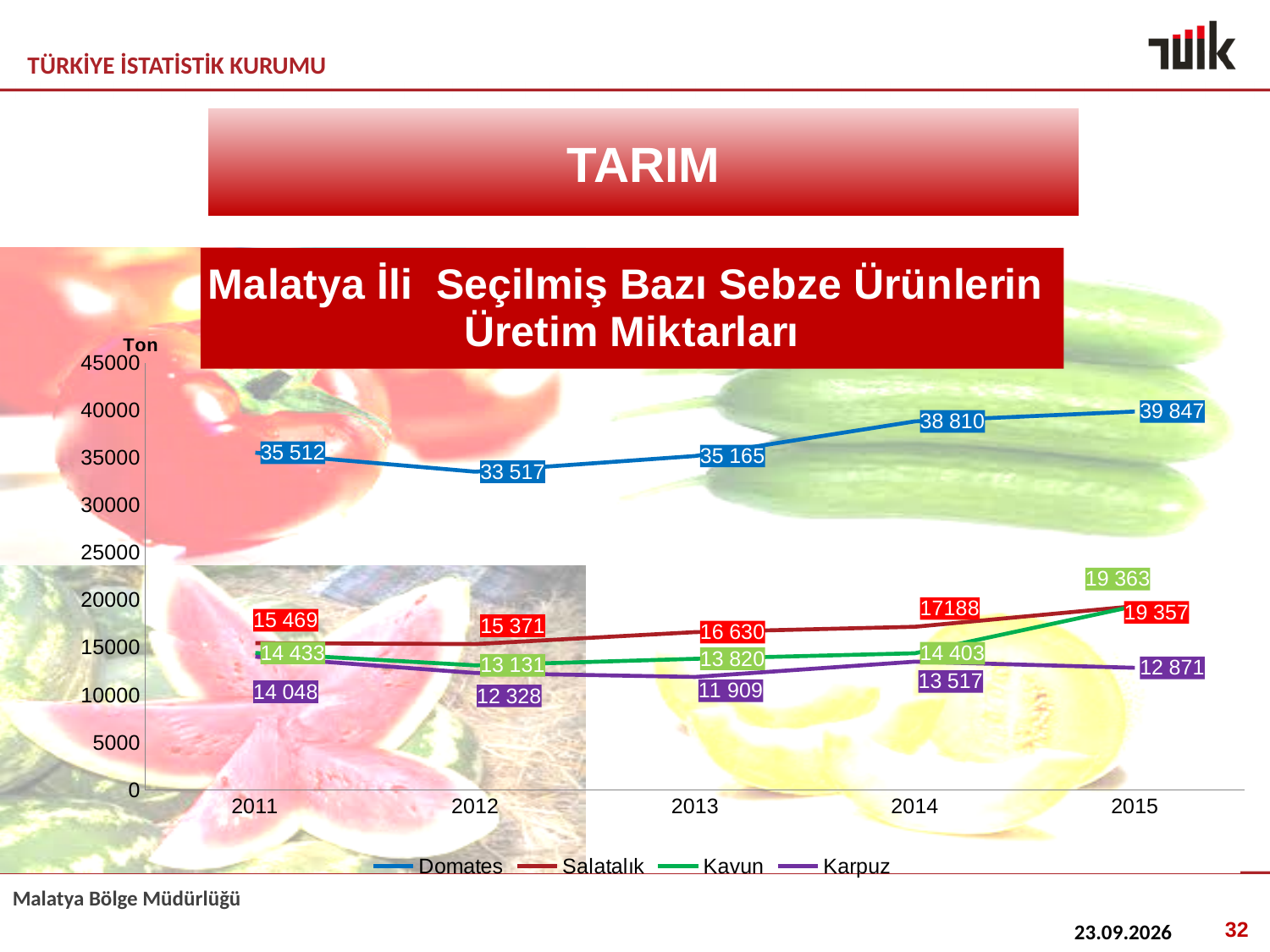
How many years are shown on the x axis? 5 What kind of chart is shown on the slide? line chart What was the Salatalık production in 2014? 17188 What was the Karpuz production in 2013? 11 909 Which is larger: Domates production in 2014 or in 2013? 2014 What is the difference between Domates production in 2015 and in 2011? 4 335 In which year was Domates production lowest? 2012 Does Domates production rise or fall from 2013 to 2015? rise What was the Kavun production in 2012? 13 131 What was the Domates production in 2015? 39 847 In which year was Salatalık production highest? 2015 How many series does the legend list? 4